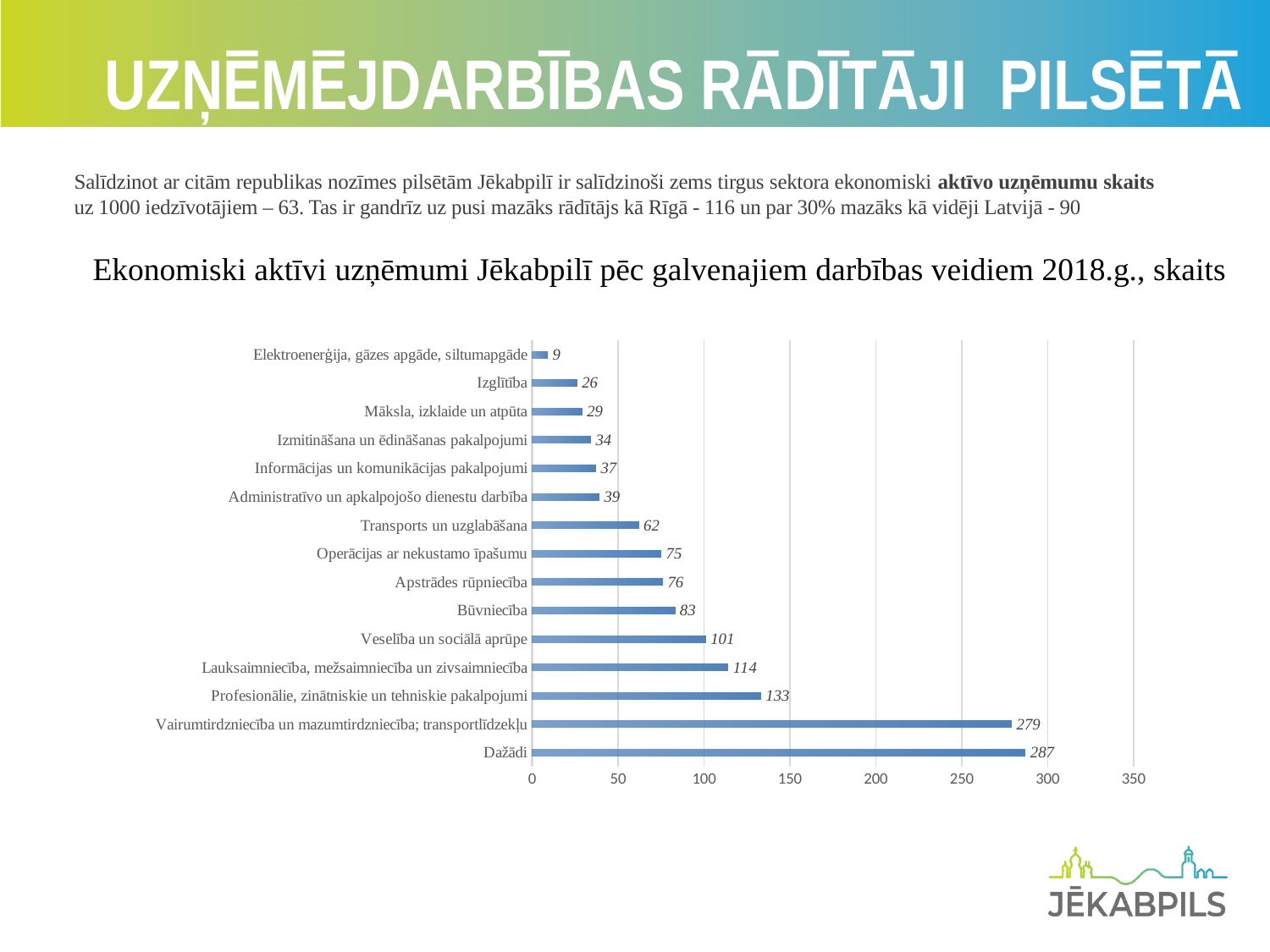
What is the difference between the values for Profesionālie, zinātniskie un tehniskie pakalpojumi and Lauksaimniecība, mežsaimniecība un zivsaimniecība? 19 How many categories are shown in the chart? 15 Is the value for Profesionālie, zinātniskie un tehniskie pakalpojumi greater or less than 150? less What is the value for Veselība un sociālā aprūpe? 101 What is the value for Transports un uzglabāšana? 62 What is the title of the chart? Ekonomiski aktīvi uzņēmumi Jēkabpilī pēc galvenajiem darbības veidiem 2018.g., skaits Which category has the lowest value? Elektroenerģija, gāzes apgāde, siltumapgāde What kind of chart is shown on the slide? bar chart Which category has the highest value? Dažādi What is the difference between the values for Dažādi and Vairumtirdzniecība un mazumtirdzniecība; transportlīdzekļu? 8 What is the value for Būvniecība? 83 Which is larger, the value for Izglītība or the value for Izmitināšana un ēdināšanas pakalpojumi? Izmitināšana un ēdināšanas pakalpojumi